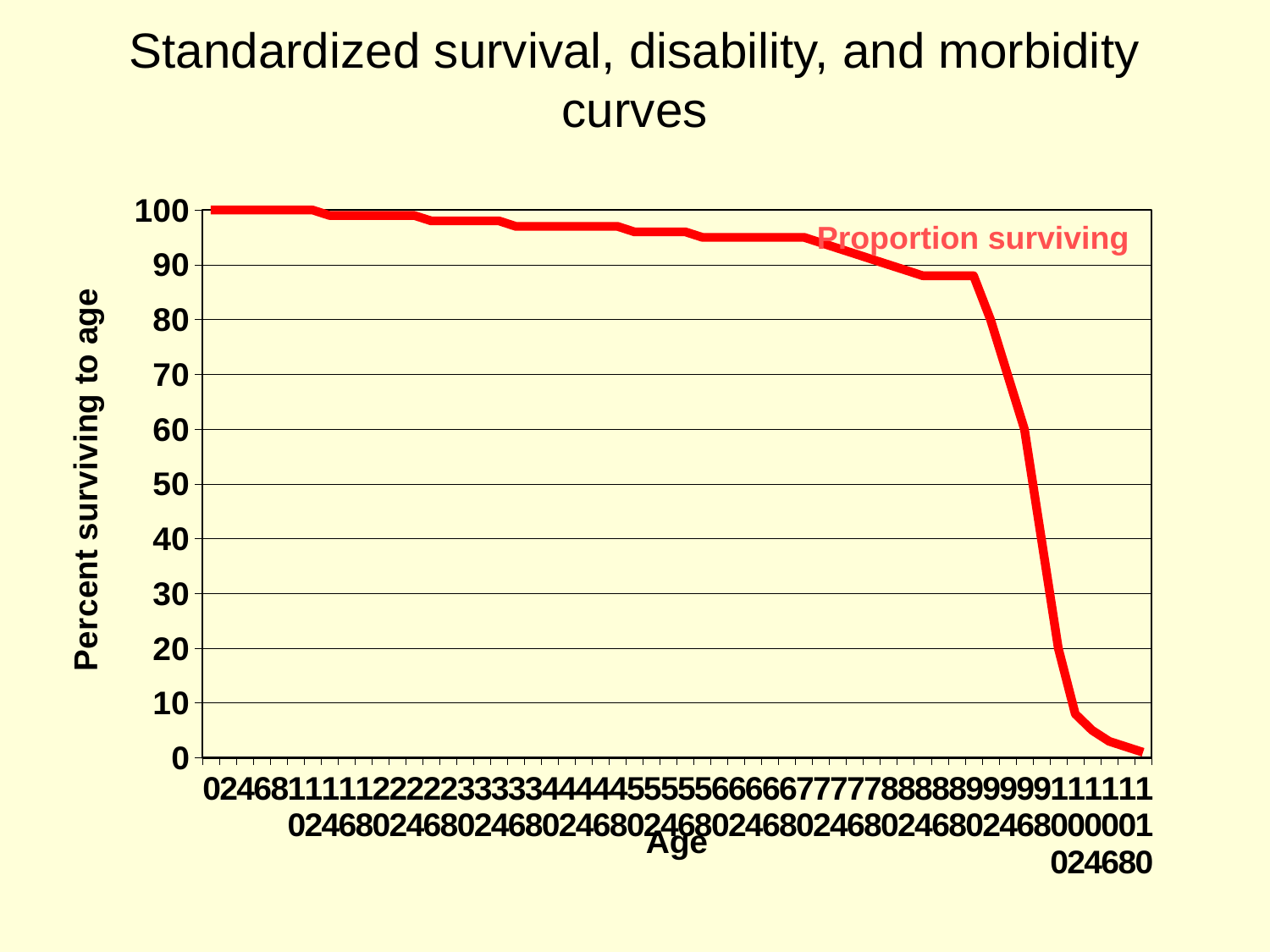
Does the proportion surviving rise or fall as age increases along the x axis? fall What is the title of the chart? Standardized survival, disability, and morbidity curves Is the percent surviving at age 50 greater or less than 90? greater What kind of chart is shown on the slide? line chart What is the percent surviving at age 0? 100 What is the name of the plotted series? Proportion surviving Is the percent surviving at age 90 greater or less than 80? greater What is the label of the y axis? Percent surviving to age At which age is the percent surviving lowest? 110 Which is larger, the percent surviving at age 80 or at age 100? age 80